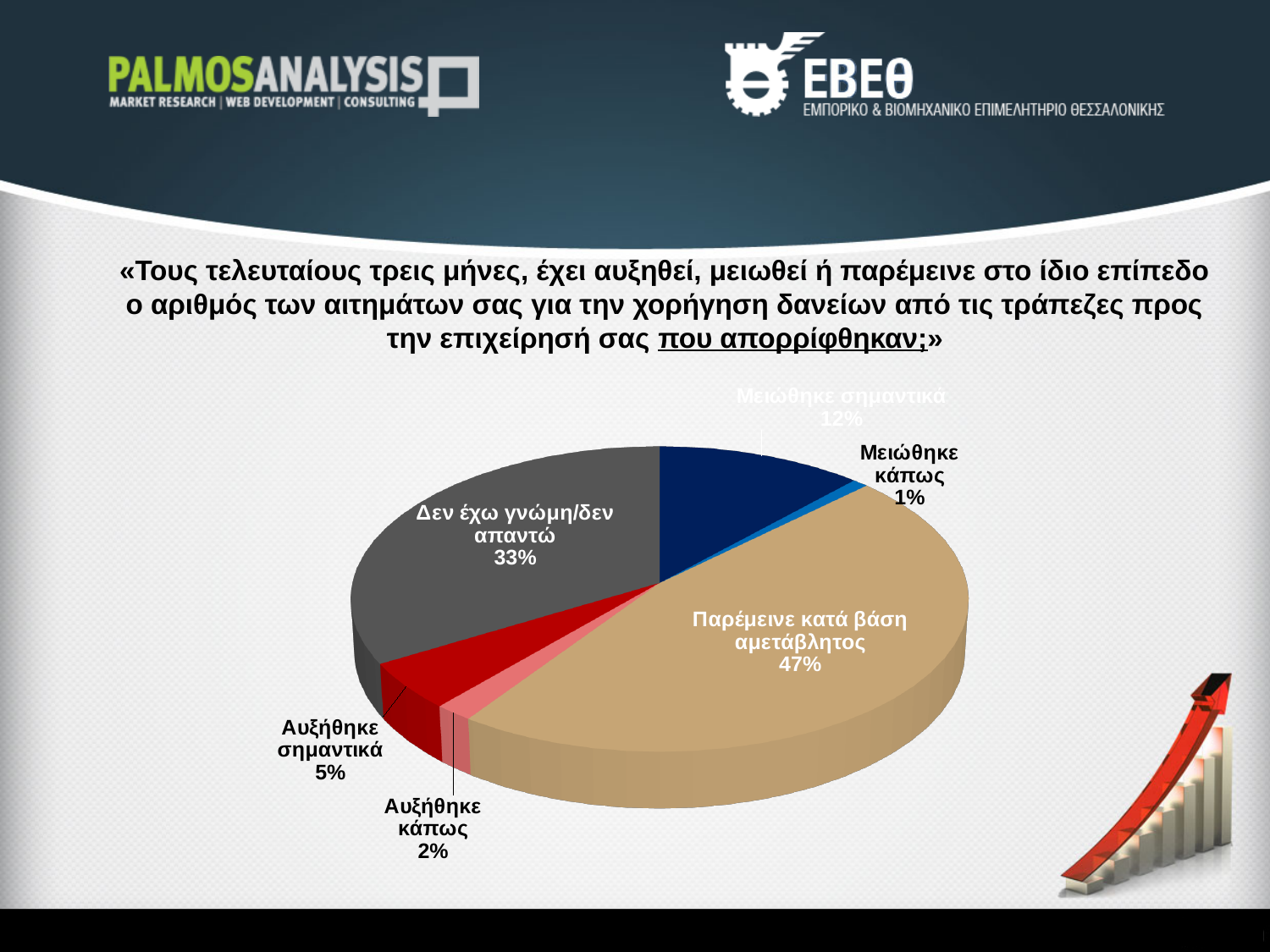
Which response has the largest share of the pie? Παρέμεινε κατά βάση αμετάβλητος What kind of chart is shown on the slide? Pie chart What percentage of respondents answered «Παρέμεινε κατά βάση αμετάβλητος»? 47% What percentage of respondents answered «Μειώθηκε κάπως»? 1% What percentage of respondents answered «Αυξήθηκε σημαντικά»? 5% How many slices does the pie chart have? 6 What percentage of respondents answered «Αυξήθηκε κάπως»? 2% Which is larger: the share for «Αυξήθηκε σημαντικά» or the share for «Αυξήθηκε κάπως»? Αυξήθηκε σημαντικά What is the combined share of «Αυξήθηκε σημαντικά» and «Αυξήθηκε κάπως»? 7% What percentage of respondents answered «Δεν έχω γνώμη/δεν απαντώ»? 33% What is the difference in percentage points between «Παρέμεινε κατά βάση αμετάβλητος» and «Δεν έχω γνώμη/δεν απαντώ»? 14 Which response has the smallest share of the pie? Μειώθηκε κάπως